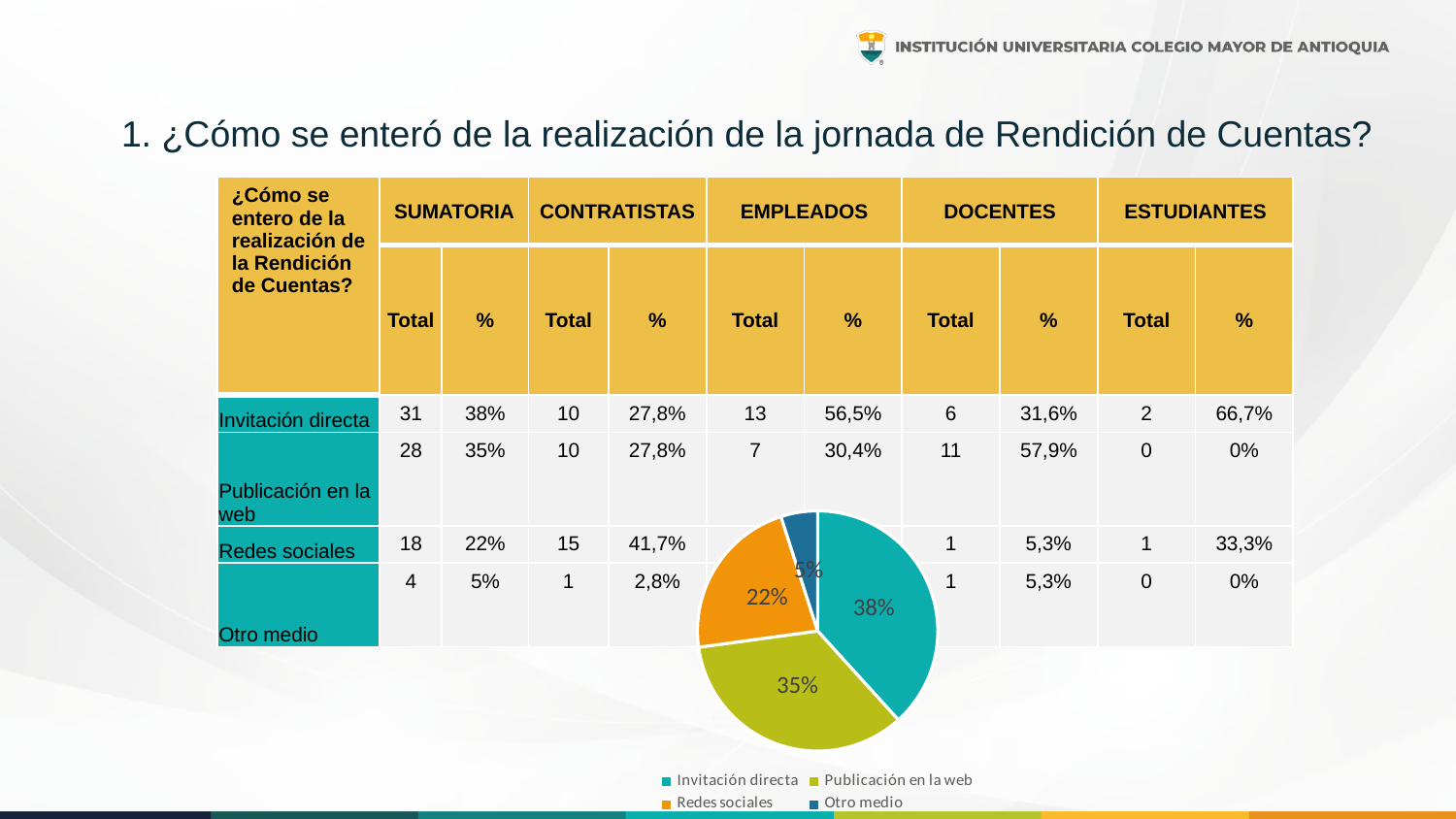
How many entries does the pie chart's legend list? 4 Which category has the largest slice in the pie chart? Invitación directa What percentage does the pie chart show for Invitación directa? 38% Which legend entry in the pie chart is shown in orange? Redes sociales What percentage does the pie chart show for Redes sociales? 22% Which category has the smallest slice in the pie chart? Otro medio What percentage does the pie chart show for Publicación en la web? 35% What is the difference in percentage points between Redes sociales and Otro medio in the pie chart? 17 What kind of chart is shown on the slide? pie chart How many slices does the pie chart have? 4 What percentage does the pie chart show for Otro medio? 5% In the pie chart, which is larger: Publicación en la web or Redes sociales? Publicación en la web